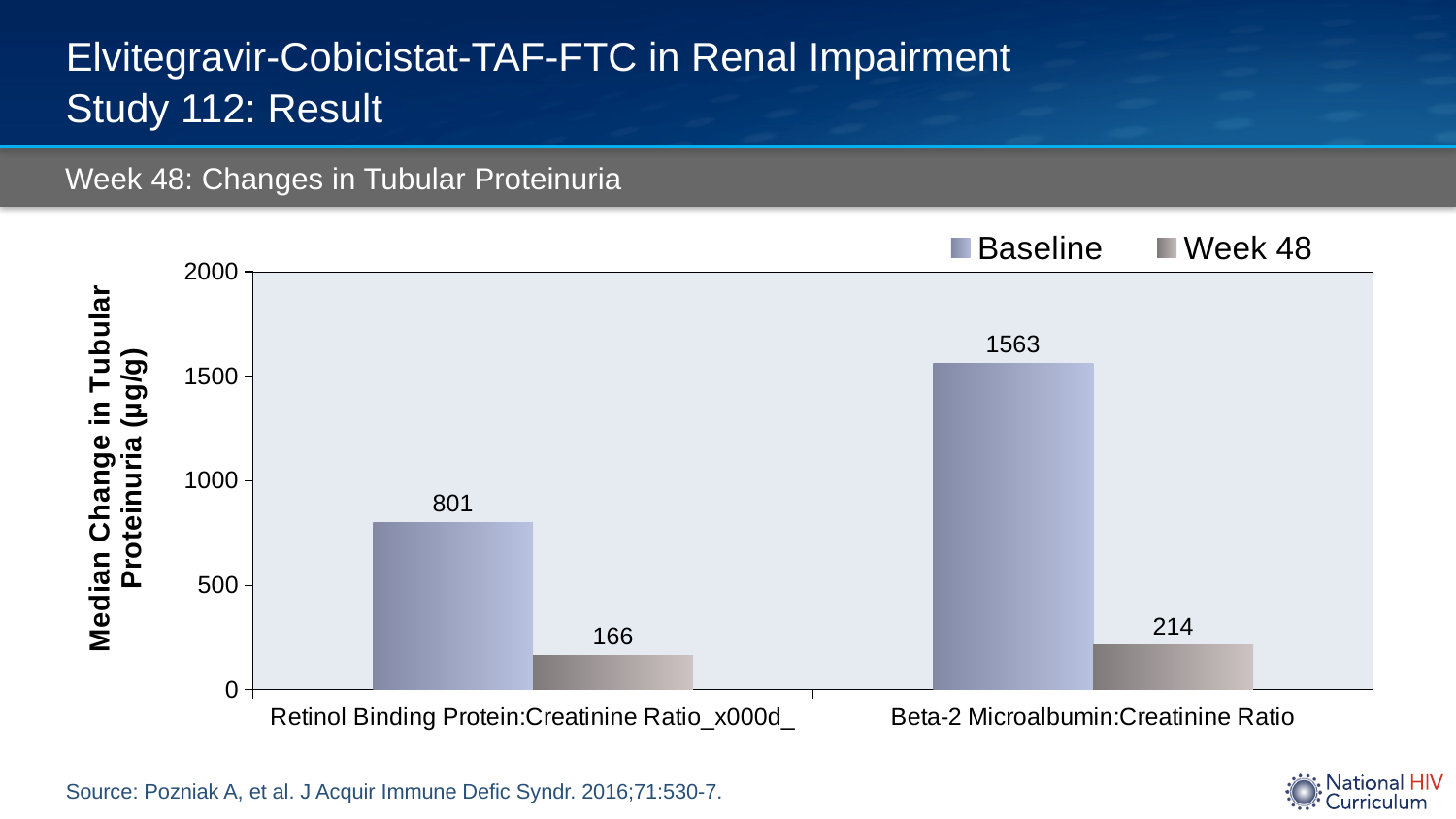
What kind of chart is shown on the slide? Bar chart What is the Baseline value for Retinol Binding Protein:Creatinine Ratio? 801 How many series does the legend list? 2 What is the y-axis label of the chart? Median Change in Tubular Proteinuria (µg/g) What is the difference between the Baseline and Week 48 values for Retinol Binding Protein:Creatinine Ratio? 635 Which is larger: the Baseline value for Retinol Binding Protein:Creatinine Ratio or the Week 48 value for Beta-2 Microalbumin:Creatinine Ratio? Baseline value for Retinol Binding Protein:Creatinine Ratio What is the Baseline value for Beta-2 Microalbumin:Creatinine Ratio? 1563 Which bar has the highest value on the chart? Baseline, Beta-2 Microalbumin:Creatinine Ratio What is the Week 48 value for Retinol Binding Protein:Creatinine Ratio? 166 Which bar has the lowest value on the chart? Week 48, Retinol Binding Protein:Creatinine Ratio What is the difference between the Baseline and Week 48 values for Beta-2 Microalbumin:Creatinine Ratio? 1349 What is the Week 48 value for Beta-2 Microalbumin:Creatinine Ratio? 214